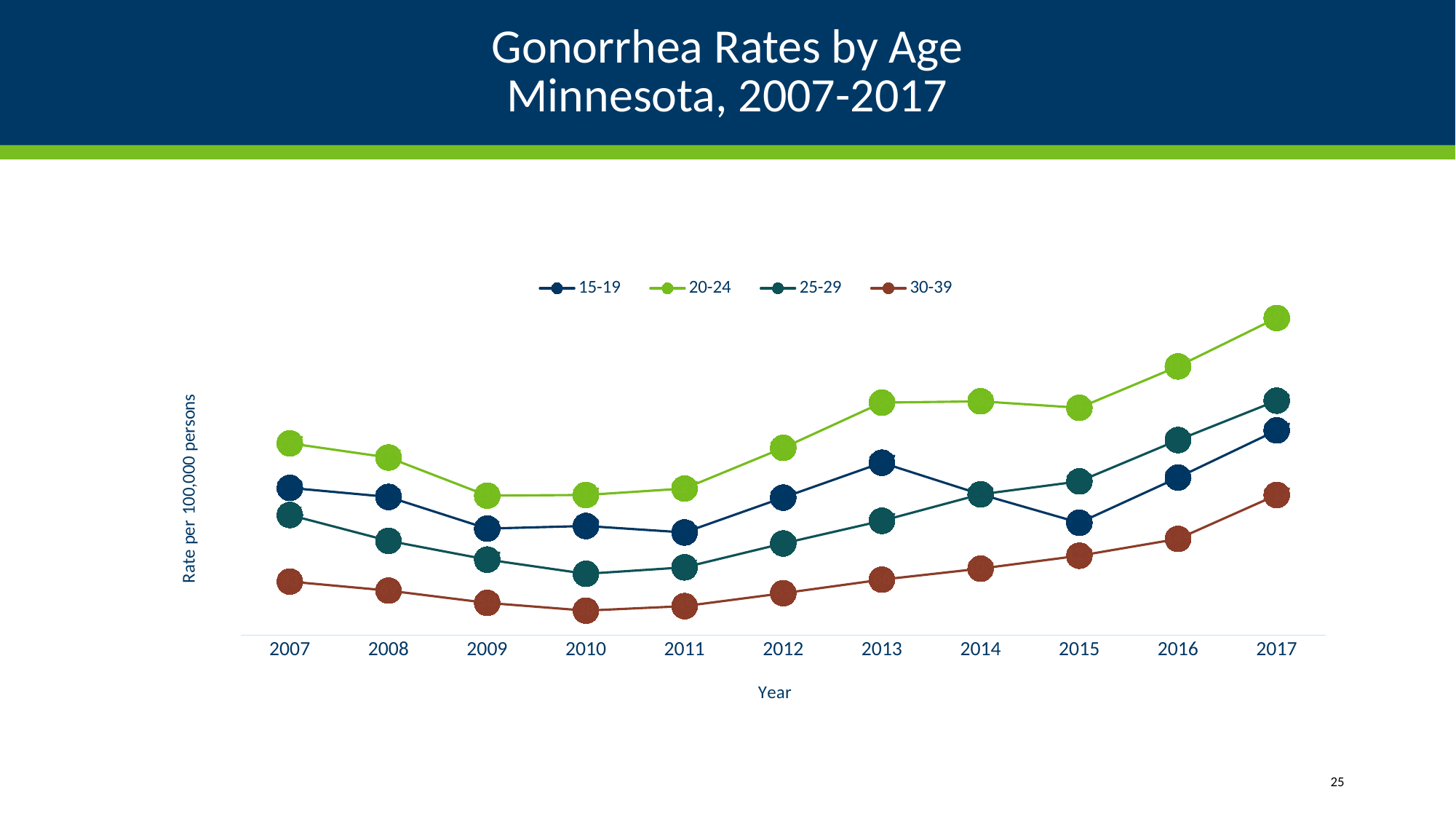
In 2015, which is higher: the rate for 25-29 or the rate for 15-19? 25-29 Which age group has the lowest rate in 2007? 30-39 How many series does the legend list? 4 How many years are plotted along the x axis? 11 Which age group has the highest rate in 2017? 20-24 What is the label on the y axis? Rate per 100,000 persons In which year is the rate for the 30-39 age group lowest? 2010 In which year is the rate for the 20-24 age group highest? 2017 Does the rate for the 20-24 age group rise or fall from 2015 to 2017? rise In 2013, which is higher: the rate for 15-19 or the rate for 25-29? 15-19 What is the title of the chart? Gonorrhea Rates by Age Minnesota, 2007-2017 What kind of chart is shown on the slide? line chart